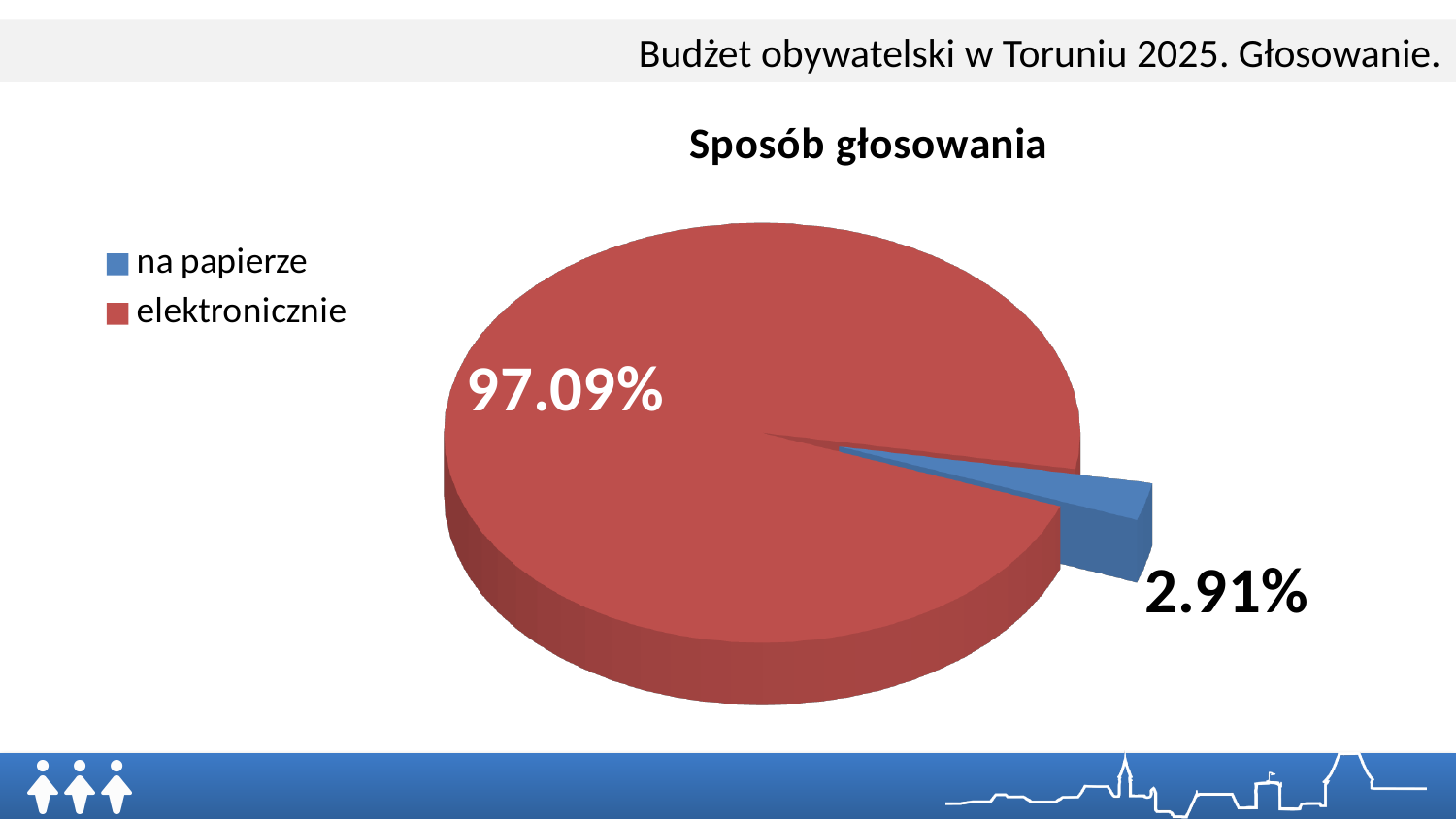
How many entries does the legend list? 2 Which category has the smallest share of the pie? na papierze Which is larger, the share for 'na papierze' or for 'elektronicznie'? elektronicznie What share of the pie does 'elektronicznie' represent? 97.09% What colour is the 'na papierze' slice? blue What is the title of the chart? Sposób głosowania Which category has the largest share of the pie? elektronicznie How many categories does the pie chart show? 2 What kind of chart is shown on the slide? pie chart What is the difference in percentage points between the 'elektronicznie' and 'na papierze' shares? 94.18 What share of the pie does 'na papierze' represent? 2.91%